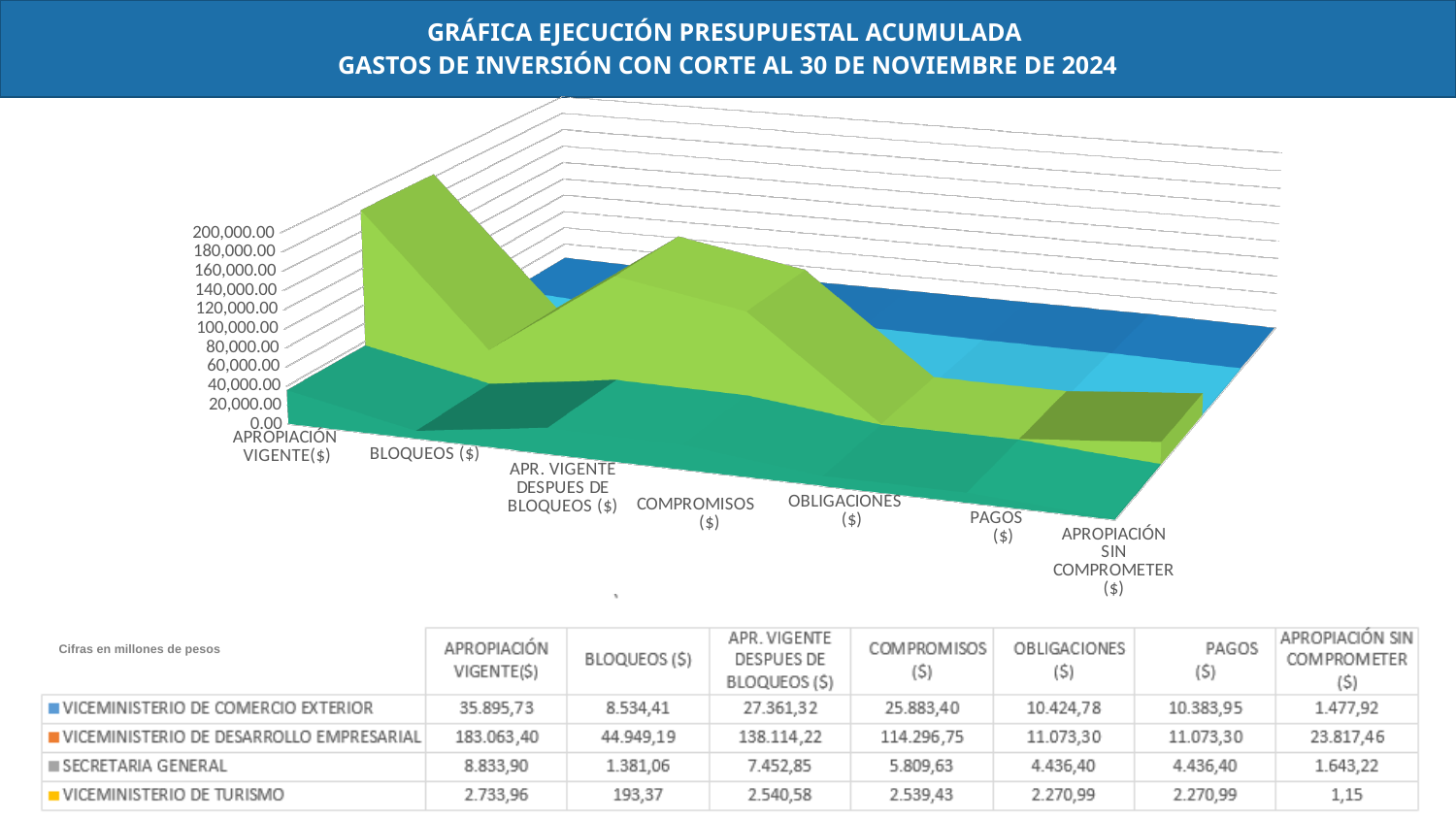
How many categories are shown along the x axis of the chart? 7 What is the APROPIACIÓN VIGENTE($) value for VICEMINISTERIO DE DESARROLLO EMPRESARIAL? 183.063,40 Which series has the highest APROPIACIÓN VIGENTE($) value? VICEMINISTERIO DE DESARROLLO EMPRESARIAL What kind of chart is shown on the slide? Area chart Is the APROPIACIÓN VIGENTE($) value for VICEMINISTERIO DE DESARROLLO EMPRESARIAL greater or less than 160,000.00? greater Which series has the lowest COMPROMISOS ($) value? VICEMINISTERIO DE TURISMO What is the difference between the APROPIACIÓN VIGENTE($) values of VICEMINISTERIO DE DESARROLLO EMPRESARIAL and VICEMINISTERIO DE COMERCIO EXTERIOR? 147.167,67 What is the APROPIACIÓN SIN COMPROMETER ($) value for VICEMINISTERIO DE TURISMO? 1,15 What is the PAGOS ($) value for SECRETARIA GENERAL? 4.436,40 Which is larger, the OBLIGACIONES ($) value for SECRETARIA GENERAL or for VICEMINISTERIO DE TURISMO? SECRETARIA GENERAL How many series does the legend in the table list? 4 What is the BLOQUEOS ($) value for VICEMINISTERIO DE COMERCIO EXTERIOR? 8.534,41